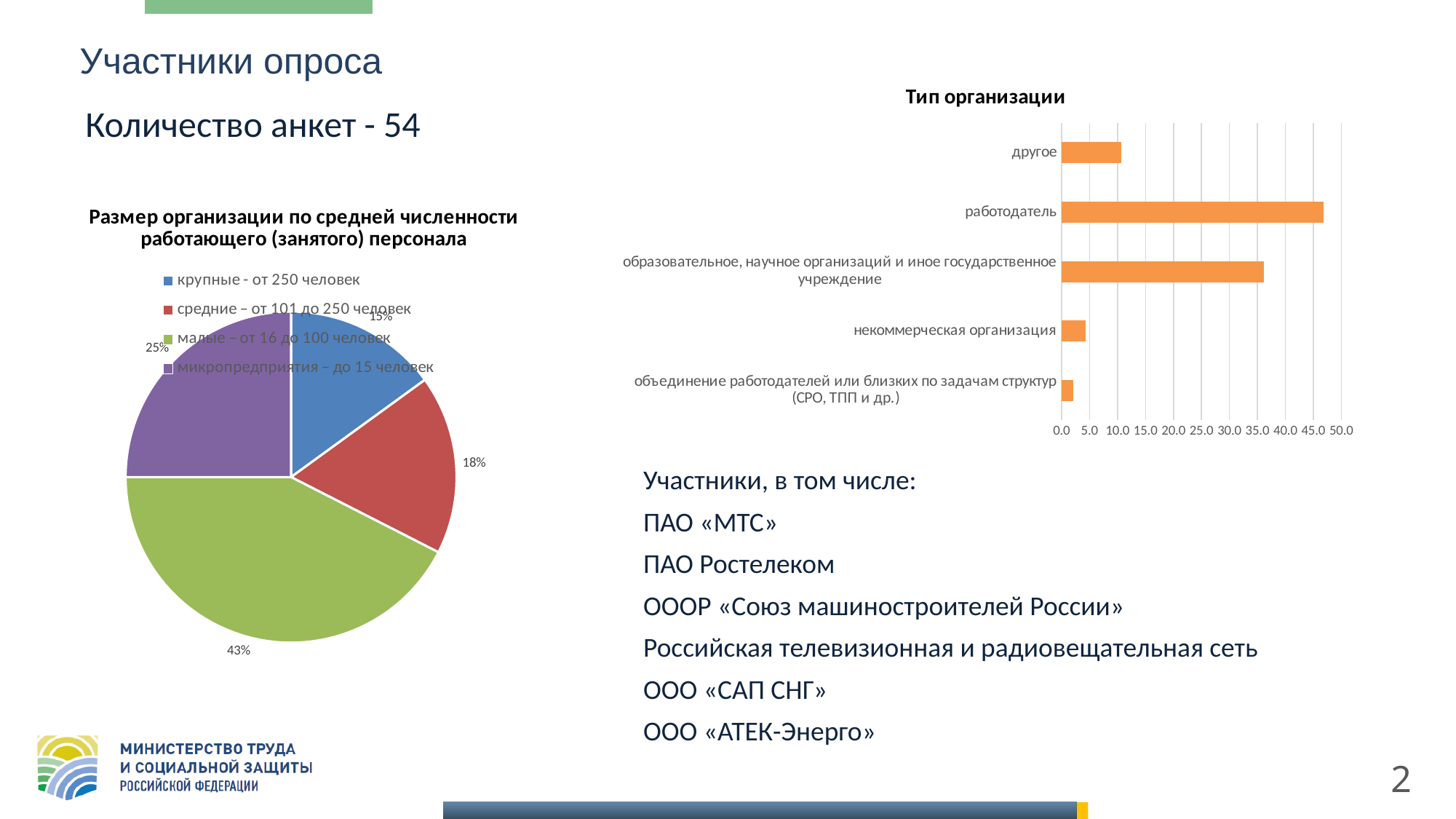
In the chart 'Тип организации', which category has the longest bar? работодатель In the chart 'Тип организации', is the value for 'работодатель' greater or less than 40.0? greater What kind of chart is 'Тип организации'? bar chart In the pie chart 'Размер организации по средней численности работающего (занятого) персонала', what share is shown for 'малые – от 16 до 100 человек'? 43% In the chart 'Тип организации', which category has the shortest bar? объединение работодателей или близких по задачам структур (СРО, ТПП и др.) How many categories does the legend of the pie chart 'Размер организации по средней численности работающего (занятого) персонала' list? 4 In the pie chart 'Размер организации по средней численности работающего (занятого) персонала', what is the difference in percentage points between 'малые – от 16 до 100 человек' and 'средние – от 101 до 250 человек'? 25 In the pie chart 'Размер организации по средней численности работающего (занятого) персонала', which category has the largest slice? малые – от 16 до 100 человек In the pie chart 'Размер организации по средней численности работающего (занятого) персонала', what share is shown for 'крупные - от 250 человек'? 15% In the pie chart 'Размер организации по средней численности работающего (занятого) персонала', what share is shown for 'микропредприятия – до 15 человек'? 25% In the pie chart 'Размер организации по средней численности работающего (занятого) персонала', which category has the smallest slice? крупные - от 250 человек In the chart 'Тип организации', is the value for 'некоммерческая организация' greater or less than 10.0? less